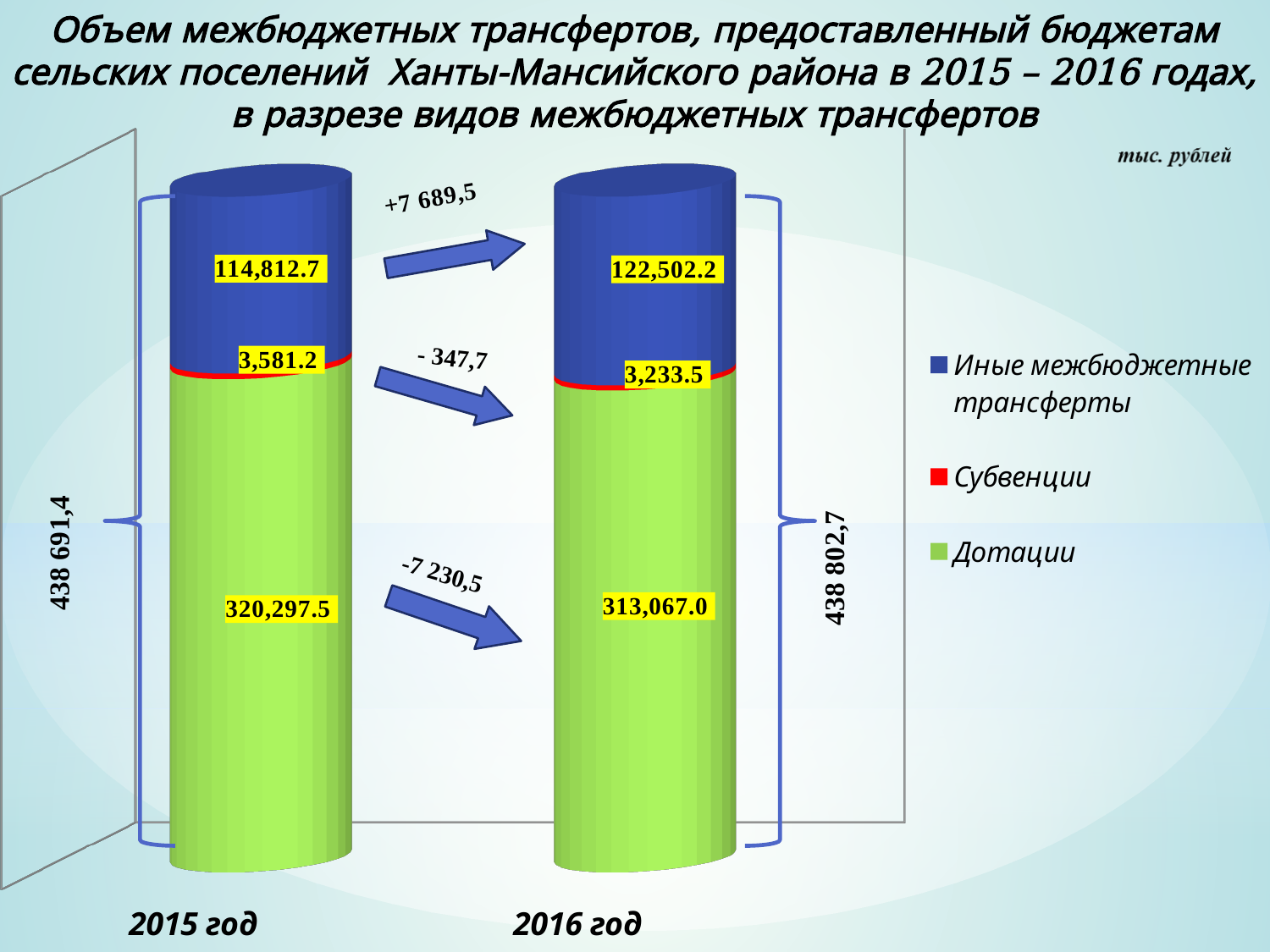
Which series has the largest value in 2016 год? Дотации By how much did Иные межбюджетные трансферты change from 2015 год to 2016 год? +7 689,5 How many series does the legend list? 3 What is the value of Субвенции for 2016 год? 3,233.5 What is the value of Иные межбюджетные трансферты for 2016 год? 122,502.2 Is Дотации larger in 2015 год or in 2016 год? 2015 год What is the value of Субвенции for 2015 год? 3,581.2 What is the value of Дотации for 2015 год? 320,297.5 Which series has the smallest value in 2015 год? Субвенции What is the total of the stacked bar for 2015 год? 438 691,4 What is the difference between Дотации in 2015 год and 2016 год? 7 230,5 What is the total of the stacked bar for 2016 год? 438 802,7